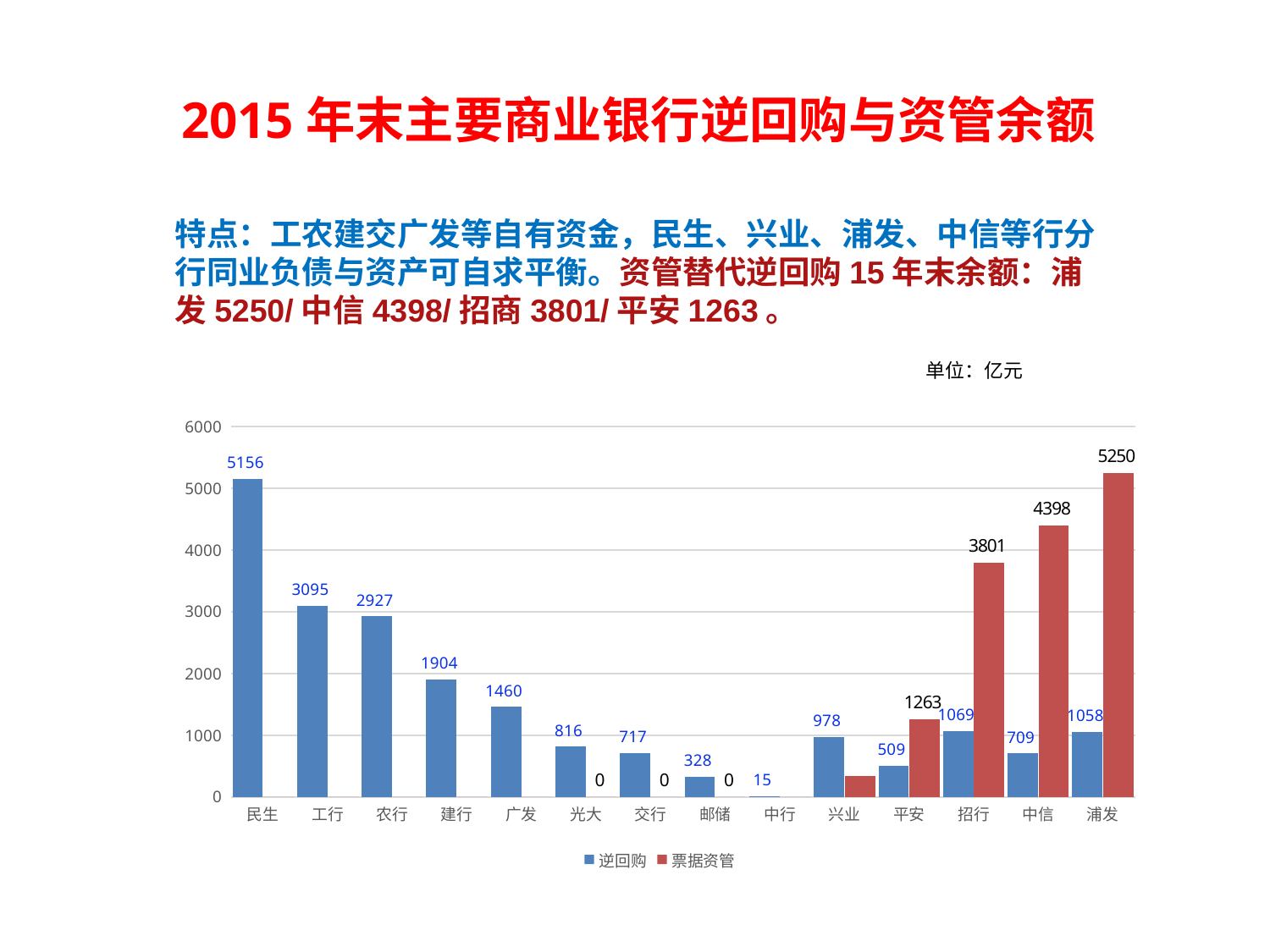
How many series does the legend list? 2 Which has a larger 逆回购 value, 工行 or 农行? 工行 Is the 票据资管 value for 兴业 greater or less than 1000? less What is the difference between the 票据资管 values of 中信 and 招行? 597 Which bank has the highest 逆回购 value? 民生 What is the difference between the 逆回购 values of 民生 and 工行? 2061 What is the 逆回购 value for 民生? 5156 How many banks are shown on the x axis? 14 What is the 票据资管 value for 平安? 1263 Which bank has the highest 票据资管 value? 浦发 What is the 票据资管 value for 浦发? 5250 Which bank has the lowest 逆回购 value? 中行